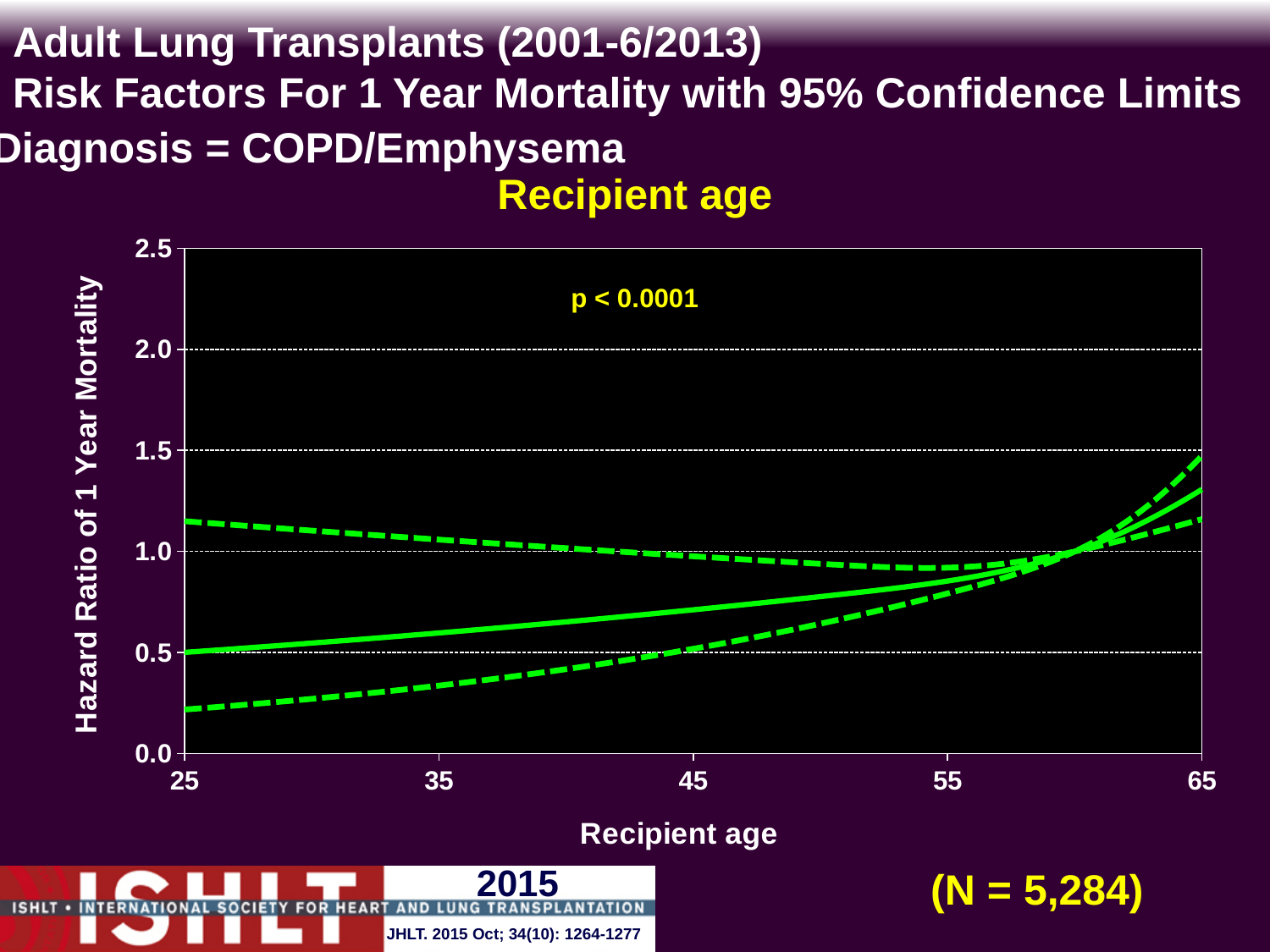
Is the lower dashed confidence limit at recipient age 25 greater or less than 0.5? less What is the label of the y axis? Hazard Ratio of 1 Year Mortality How many lines are plotted on the chart? 3 Is the solid hazard ratio line at recipient age 65 greater or less than 1.0? greater What is the p-value printed on the chart? p < 0.0001 Is the solid hazard ratio line at recipient age 45 greater or less than 0.5? greater What is the highest value shown on the y axis? 2.5 Does the solid hazard ratio line rise or fall as recipient age increases from 25 to 65? rise What kind of chart is shown on the slide? line chart